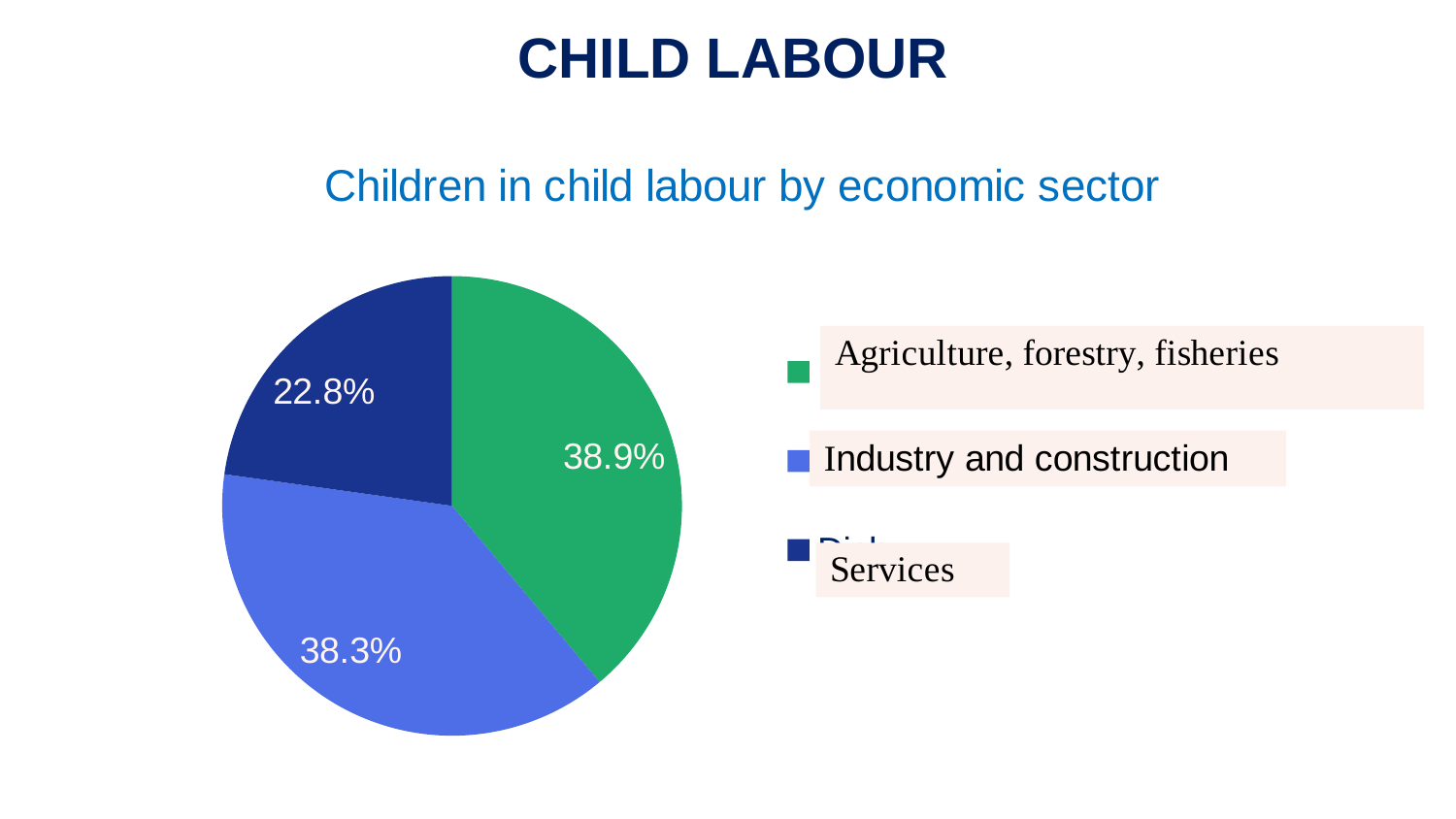
What is the difference in percentage points between the agriculture, forestry, fisheries share and the services share? 16.1 What is the title of the chart? Children in child labour by economic sector What is the difference in percentage points between the industry and construction share and the services share? 15.5 How many sectors are shown in the pie chart? 3 What type of chart is shown on the slide? Pie chart Which economic sector has the largest share of children in child labour? Agriculture, forestry, fisheries What share of children in child labour is in agriculture, forestry, fisheries? 38.9% What share of children in child labour is in services? 22.8% Which economic sector has the smallest share of children in child labour? Services Which colour represents agriculture, forestry, fisheries in the pie chart? Green Which is larger, the share for industry and construction or the share for services? Industry and construction What share of children in child labour is in industry and construction? 38.3%